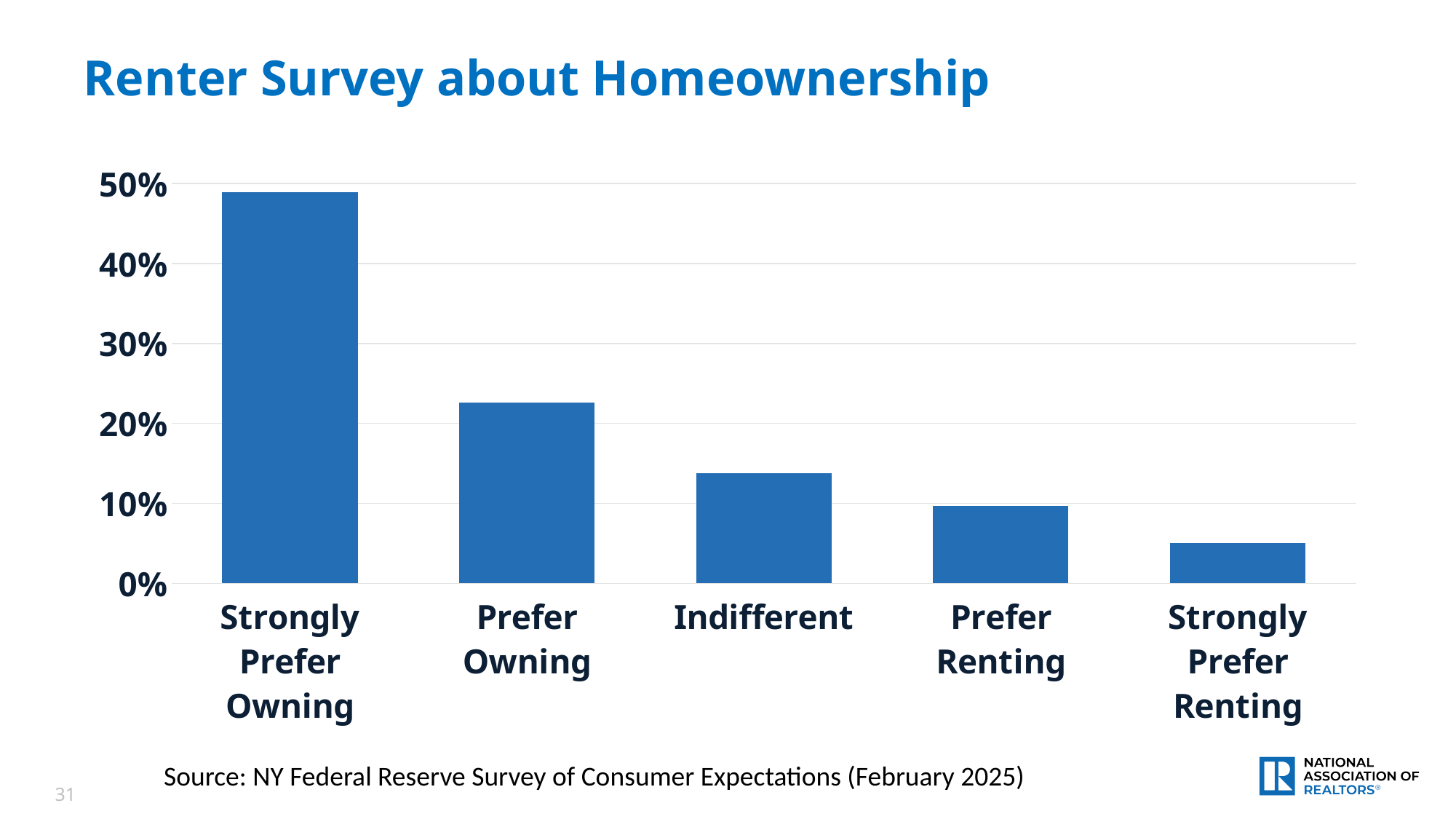
Is the value for Indifferent greater or less than 20%? less Is the value for Strongly Prefer Owning greater or less than 40%? greater What kind of chart is shown on the slide? bar chart What source is cited for the chart data? NY Federal Reserve Survey of Consumer Expectations (February 2025) Do the values rise or fall moving from left to right along the x axis? fall Which is larger, the value for Prefer Owning or the value for Indifferent? Prefer Owning Which category has the highest value in the chart? Strongly Prefer Owning Which category has the lowest value in the chart? Strongly Prefer Renting What is the title of the chart on the slide? Renter Survey about Homeownership Is the value for Prefer Owning greater or less than 30%? less How many categories are shown on the x axis of the chart? 5